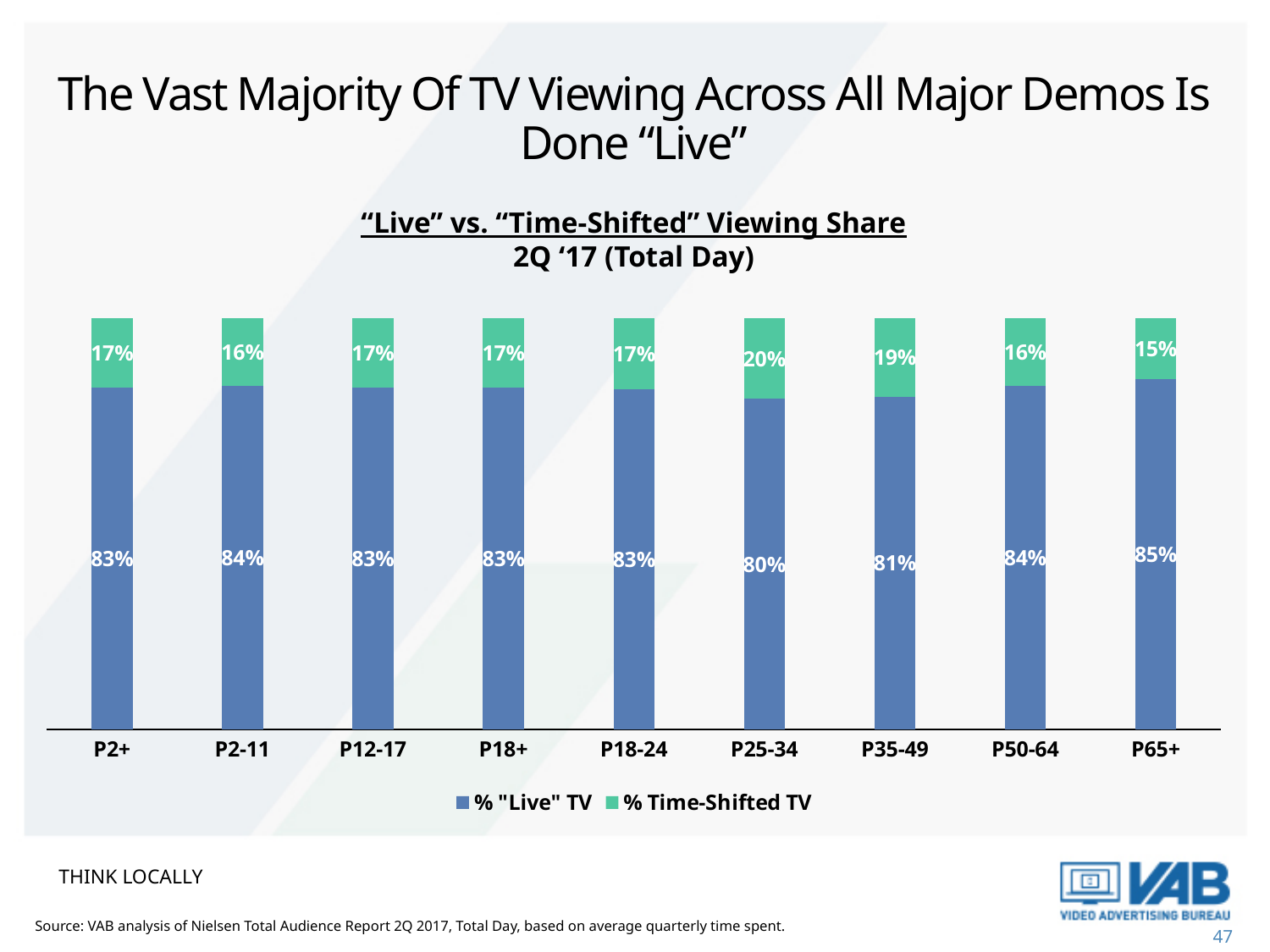
What is the % Time-Shifted TV value for P35-49? 19% What is the difference between the % "Live" TV values for P65+ and P25-34? 5% Which demo has the highest % "Live" TV value? P65+ Which demo has the lowest % "Live" TV value? P25-34 What kind of chart is shown on the slide? Stacked bar chart What is the % Time-Shifted TV value for P65+? 15% How many series does the legend list? 2 What is the total of the stacked bar for P18-24? 100% Which is larger, the % Time-Shifted TV value for P25-34 or for P50-64? P25-34 How many demo categories are shown on the x axis? 9 Which demo has the highest % Time-Shifted TV value? P25-34 What is the % "Live" TV value for P25-34? 80%